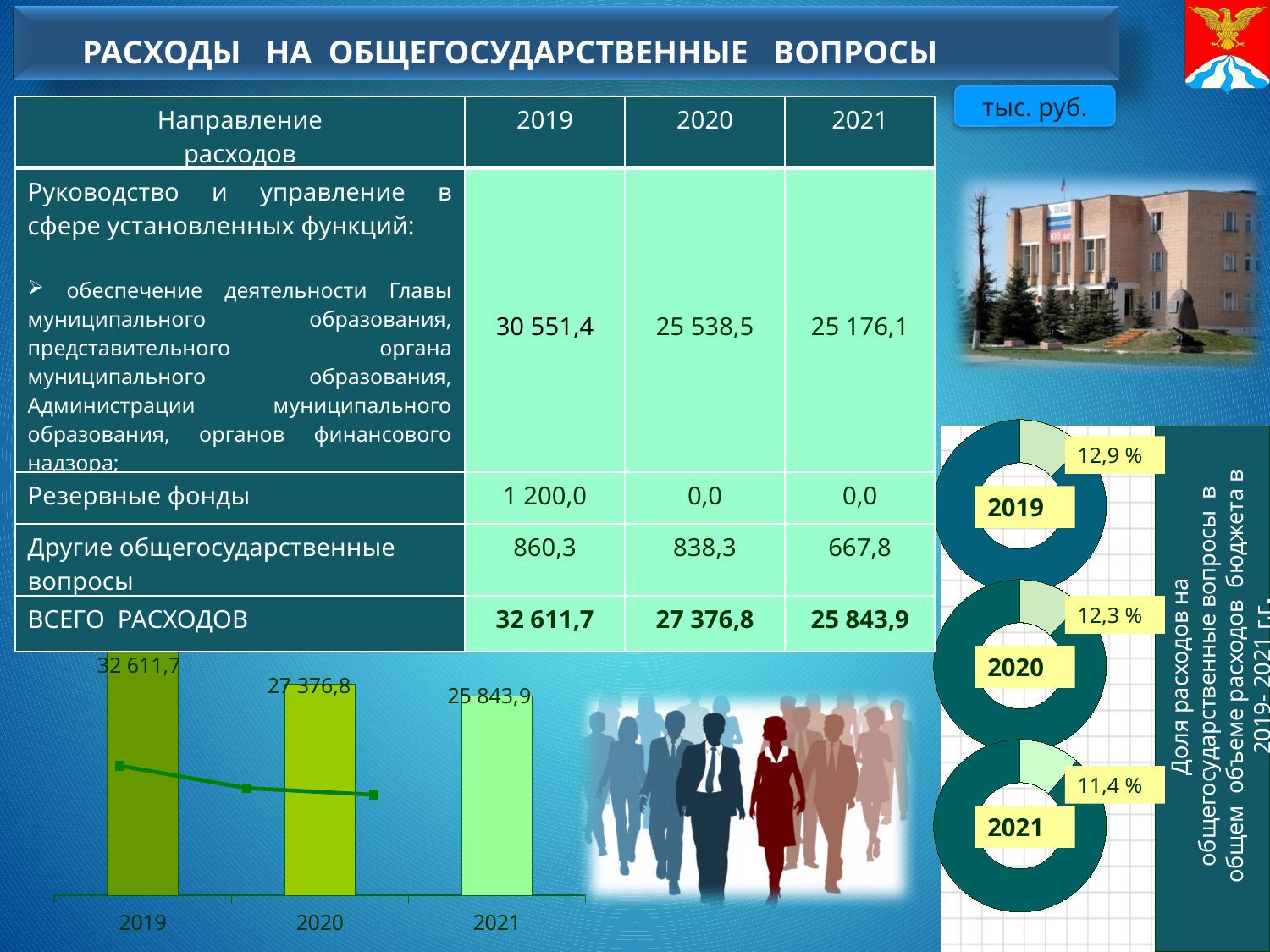
In the bar chart at the bottom left, what is the value for 2021? 25 843,9 In the bar chart at the bottom left, which year has the lowest value? 2021 How many years are shown in the bar chart at the bottom left? 3 In the donut charts on the right, which year has the lowest share? 2021 In the bar chart at the bottom left, what is the value for 2019? 32 611,7 In the bar chart at the bottom left, what is the difference between the values for 2020 and 2021? 1 532,9 What kind of chart is shown at the bottom left of the slide? bar chart In the bar chart at the bottom left, do the values rise or fall from 2019 to 2021? fall In the donut charts on the right, what share is shown for 2019? 12,9 % In the bar chart at the bottom left, what is the difference between the values for 2019 and 2020? 5 234,9 In the bar chart at the bottom left, which year has the highest value? 2019 In the bar chart at the bottom left, what is the value for 2020? 27 376,8